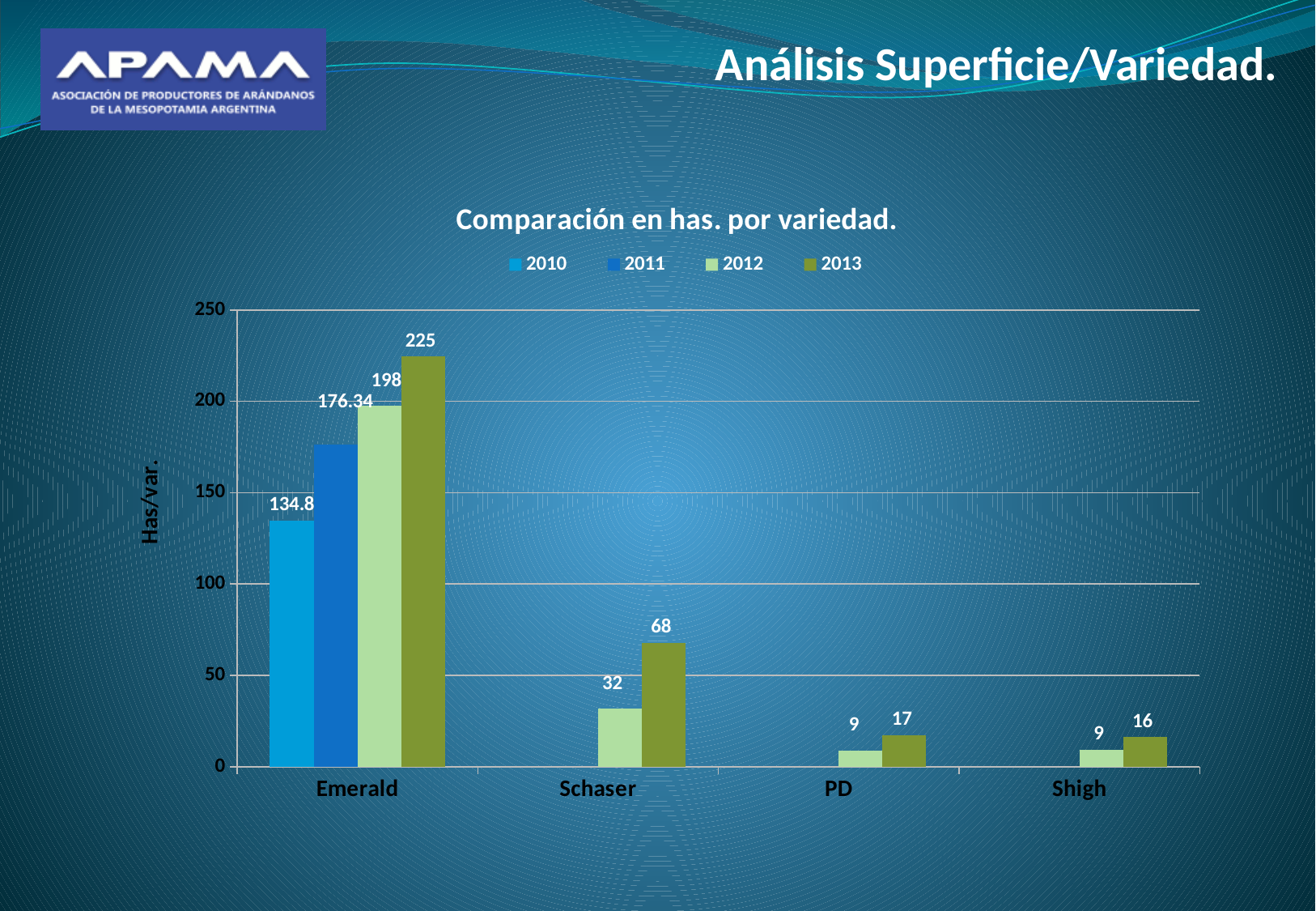
What kind of chart is shown? Bar chart What is the title of the chart? Comparación en has. por variedad. Which is larger for Emerald, the 2011 value or the 2012 value? 2012 What is the 2013 value for Emerald? 225 Which variety has the lowest 2013 value? Shigh Which variety has the highest 2013 value? Emerald What is the 2013 value for PD? 17 What is the 2010 value for Emerald? 134.8 How many varieties are shown on the x axis? 4 What is the 2012 value for Schaser? 32 How many series does the legend list? 4 What is the difference between the 2013 and 2012 values for Schaser? 36